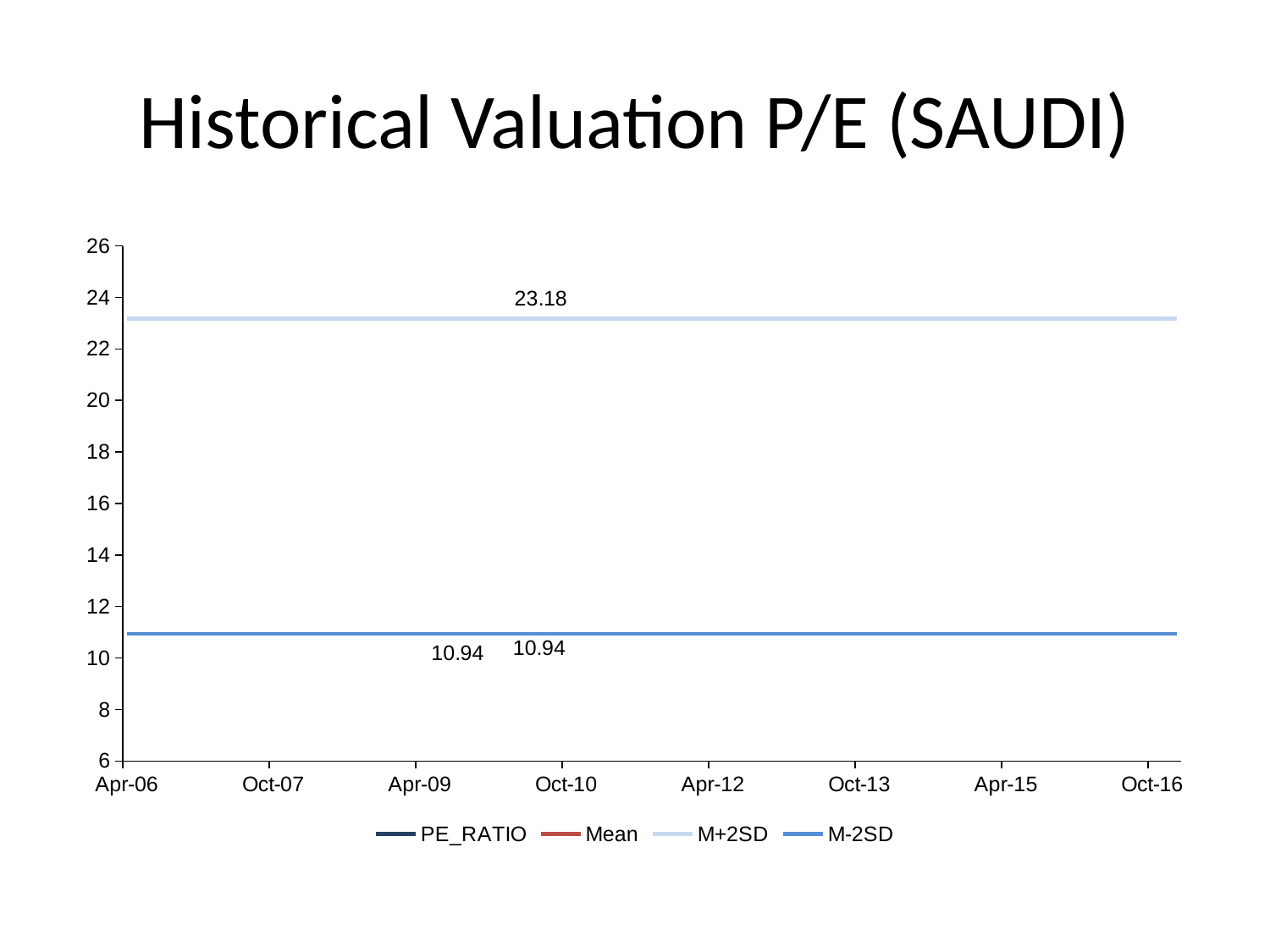
How many series does the legend list? 4 What is the highest value shown on the y axis? 26 Does the M+2SD line rise, fall, or stay flat from Apr-06 to Oct-16? stays flat What is the title of the chart? Historical Valuation P/E (SAUDI) What value is labelled on the M-2SD line? 10.94 Which line is higher on the chart, M+2SD or M-2SD? M+2SD What value is labelled on the M+2SD line? 23.18 What is the difference between the M+2SD value (23.18) and the M-2SD value (10.94)? 12.24 How many date labels are shown on the x axis? 8 What kind of chart is shown on the slide? line chart Is the value of the M+2SD line greater or less than 22? greater Is the value of the M-2SD line greater or less than 12? less